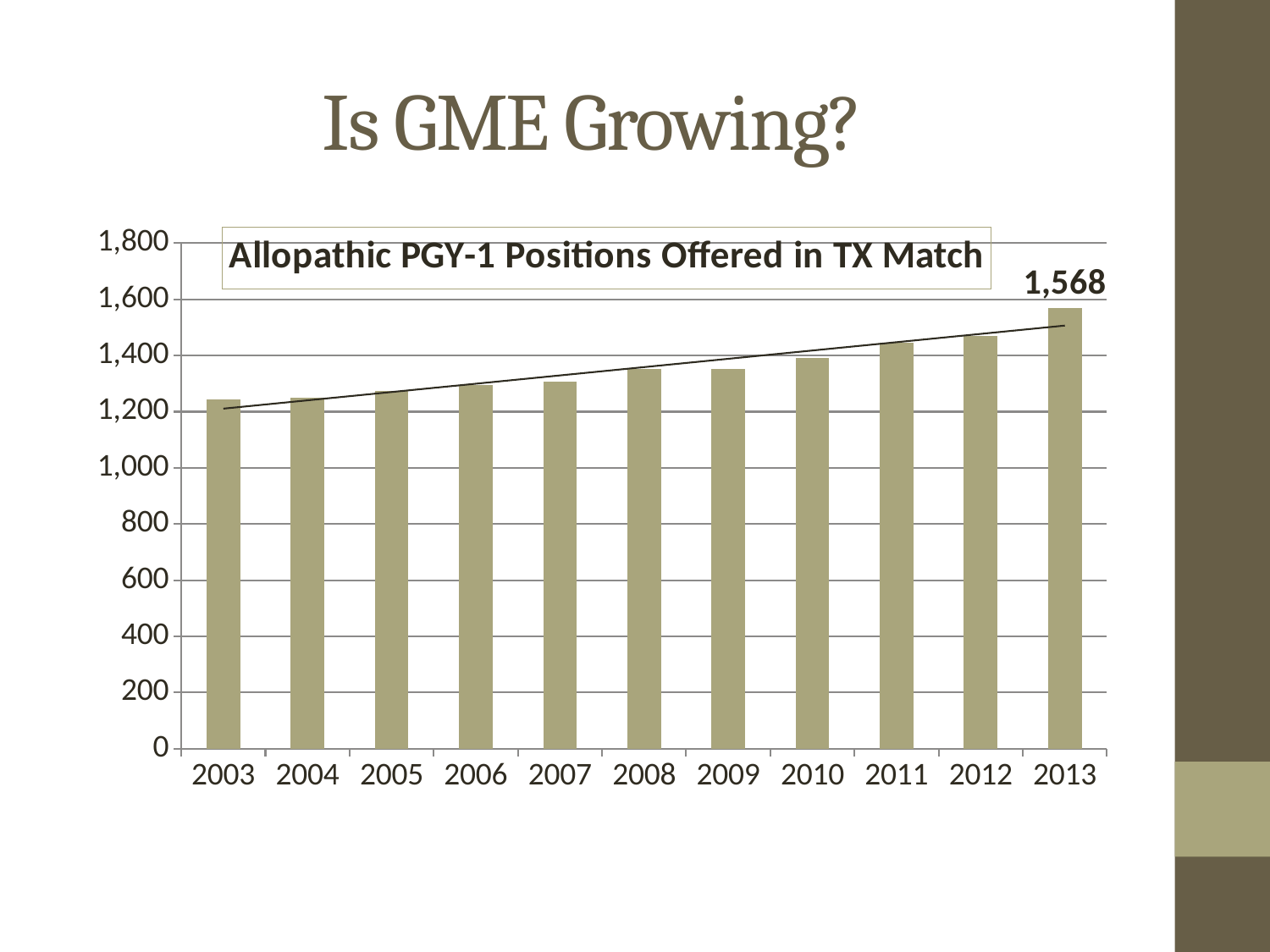
Which year has the larger value, 2013 or 2003? 2013 How many years are shown on the x axis of the chart? 11 Is the value for 2011 greater or less than 1,400? greater What kind of chart is used to show the Allopathic PGY-1 positions offered? bar chart What is the value shown for 2013 in the Allopathic PGY-1 Positions Offered in TX Match chart? 1,568 What is the title of the chart on the slide? Allopathic PGY-1 Positions Offered in TX Match Is the value for 2008 greater or less than 1,400? less Do the values generally rise or fall from 2003 to 2013? rise Which year has the highest number of Allopathic PGY-1 positions offered? 2013 Is the value for 2003 greater or less than 1,200? greater Which year has the larger value, 2011 or 2007? 2011